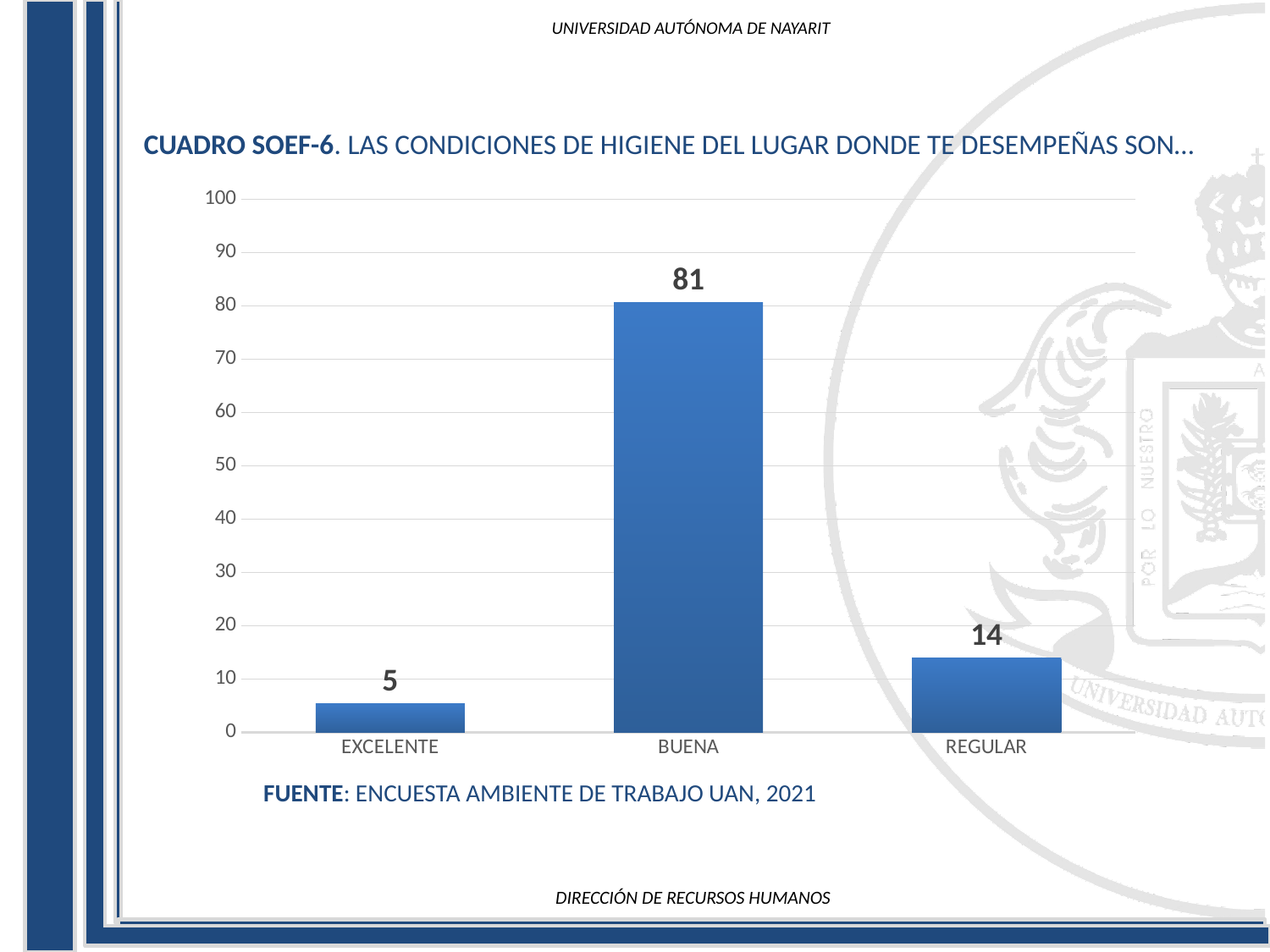
What kind of chart is shown on the slide? bar chart Which category has the lowest value? EXCELENTE Which is larger, the value for REGULAR or the value for EXCELENTE? REGULAR What is the difference between the values for BUENA and REGULAR? 67 Is the value for BUENA greater or less than 70? greater What is the value for EXCELENTE? 5 What source is cited below the chart? ENCUESTA AMBIENTE DE TRABAJO UAN, 2021 Which category has the highest value? BUENA How many categories are shown on the x axis? 3 What is the difference between the values for REGULAR and EXCELENTE? 9 What is the value for BUENA? 81 What is the value for REGULAR? 14